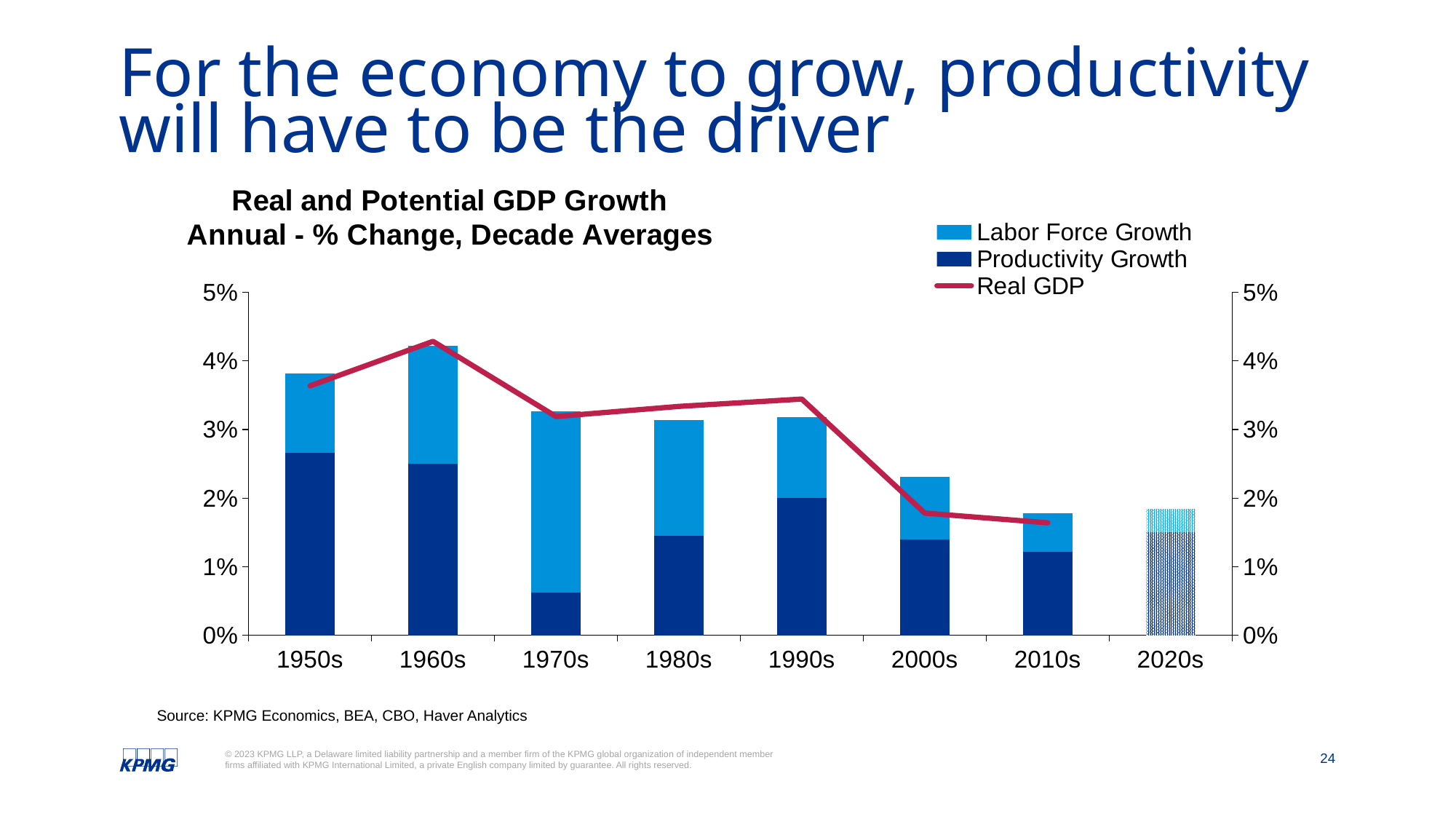
Does the Real GDP line rise or fall from the 1990s to the 2010s? fall Is the Productivity Growth value for the 1970s greater or less than 1%? less What kind of chart is shown on the slide? bar chart with a line overlay Which is larger, the Productivity Growth segment for the 1950s or for the 1990s? 1950s How many decades are shown on the x axis? 8 Which decade has the smallest Productivity Growth segment? 1970s Is the Real GDP value for the 2010s greater or less than 2%? less Is the total stacked bar for the 2000s greater or less than 2%? greater How many series does the legend list? 3 Which decade has the tallest stacked bar (highest potential GDP growth)? 1960s Which decade's bar is drawn with a hatched pattern rather than solid fill? 2020s